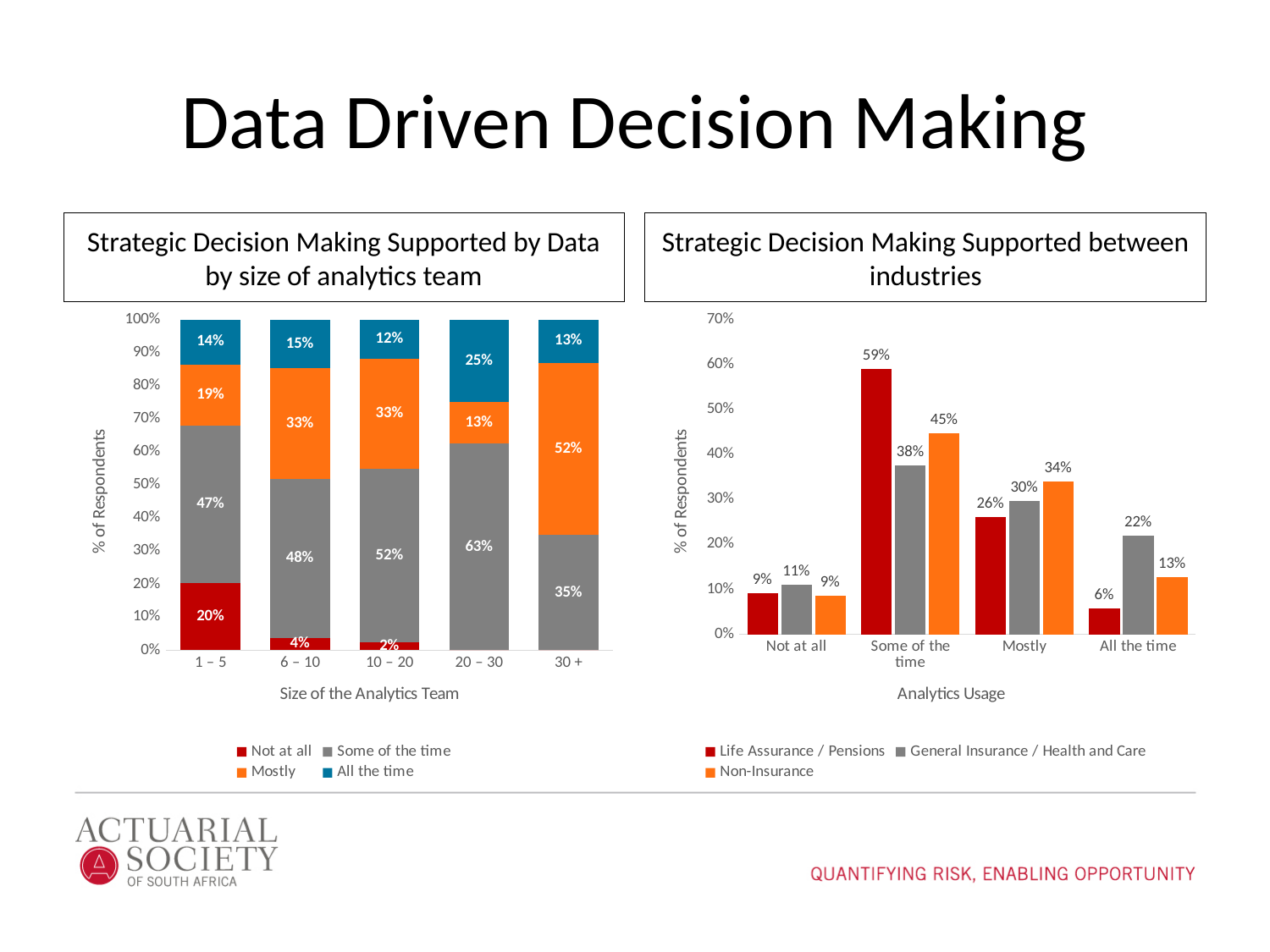
What kind of chart is 'Strategic Decision Making Supported between industries'? Bar chart In the chart 'Strategic Decision Making Supported between industries', what is the label on the x axis? Analytics Usage In the chart 'Strategic Decision Making Supported by Data by size of analytics team', what is the 'Not at all' value for the 1 – 5 team size? 20% In the chart 'Strategic Decision Making Supported between industries', what is the Life Assurance / Pensions value for 'Some of the time'? 59% In the chart 'Strategic Decision Making Supported by Data by size of analytics team', which team size has the highest 'Mostly' value? 30 + In the chart 'Strategic Decision Making Supported by Data by size of analytics team', what is the difference between the 'All the time' values for 20 – 30 and 10 – 20? 13% In the chart 'Strategic Decision Making Supported by Data by size of analytics team', how many series does the legend list? 4 In the chart 'Strategic Decision Making Supported between industries', which is larger for 'Mostly': General Insurance / Health and Care or Non-Insurance? Non-Insurance In the chart 'Strategic Decision Making Supported between industries', which industry has the lowest value for 'All the time'? Life Assurance / Pensions In the chart 'Strategic Decision Making Supported between industries', what is the difference between the Non-Insurance and General Insurance / Health and Care values for 'Some of the time'? 7% In the chart 'Strategic Decision Making Supported by Data by size of analytics team', how many team size categories are shown on the x axis? 5 In the chart 'Strategic Decision Making Supported by Data by size of analytics team', what is the 'Some of the time' value for the 20 – 30 team size? 63%